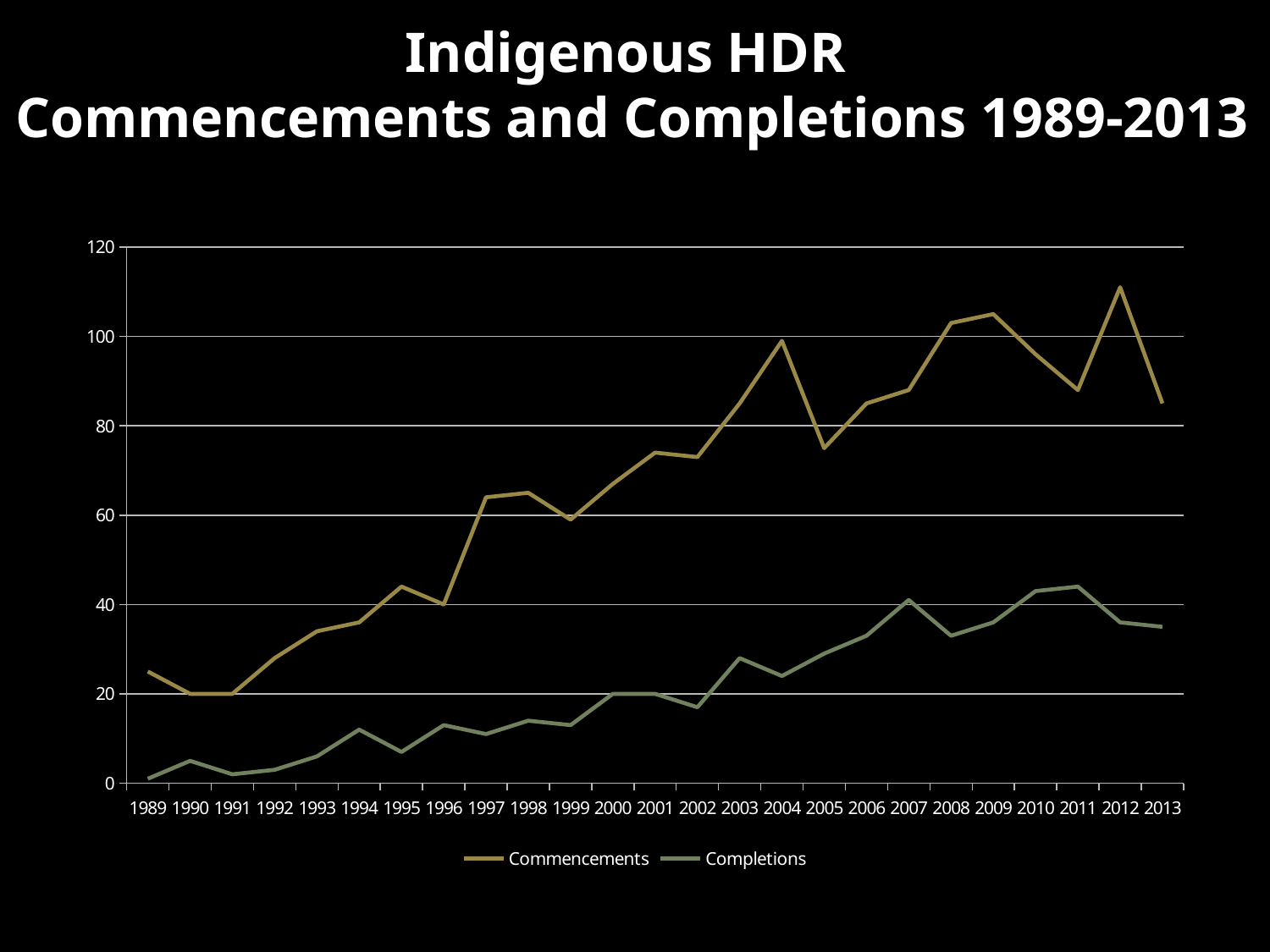
How many years are shown on the x axis? 25 Is the value for Completions in 2011 greater or less than 40? greater Is the value for Commencements in 2005 greater or less than 80? less Overall, do Completions rise or fall from 1989 to 2013? rise How many series does the legend list? 2 What kind of chart is shown on the slide? line chart Is the value for Completions in 1995 greater or less than 20? less In which year are Completions at their lowest value? 1989 Which series has the higher value in 2013, Commencements or Completions? Commencements In which year do Commencements reach their highest value? 2012 What is the title of the chart? Indigenous HDR Commencements and Completions 1989-2013